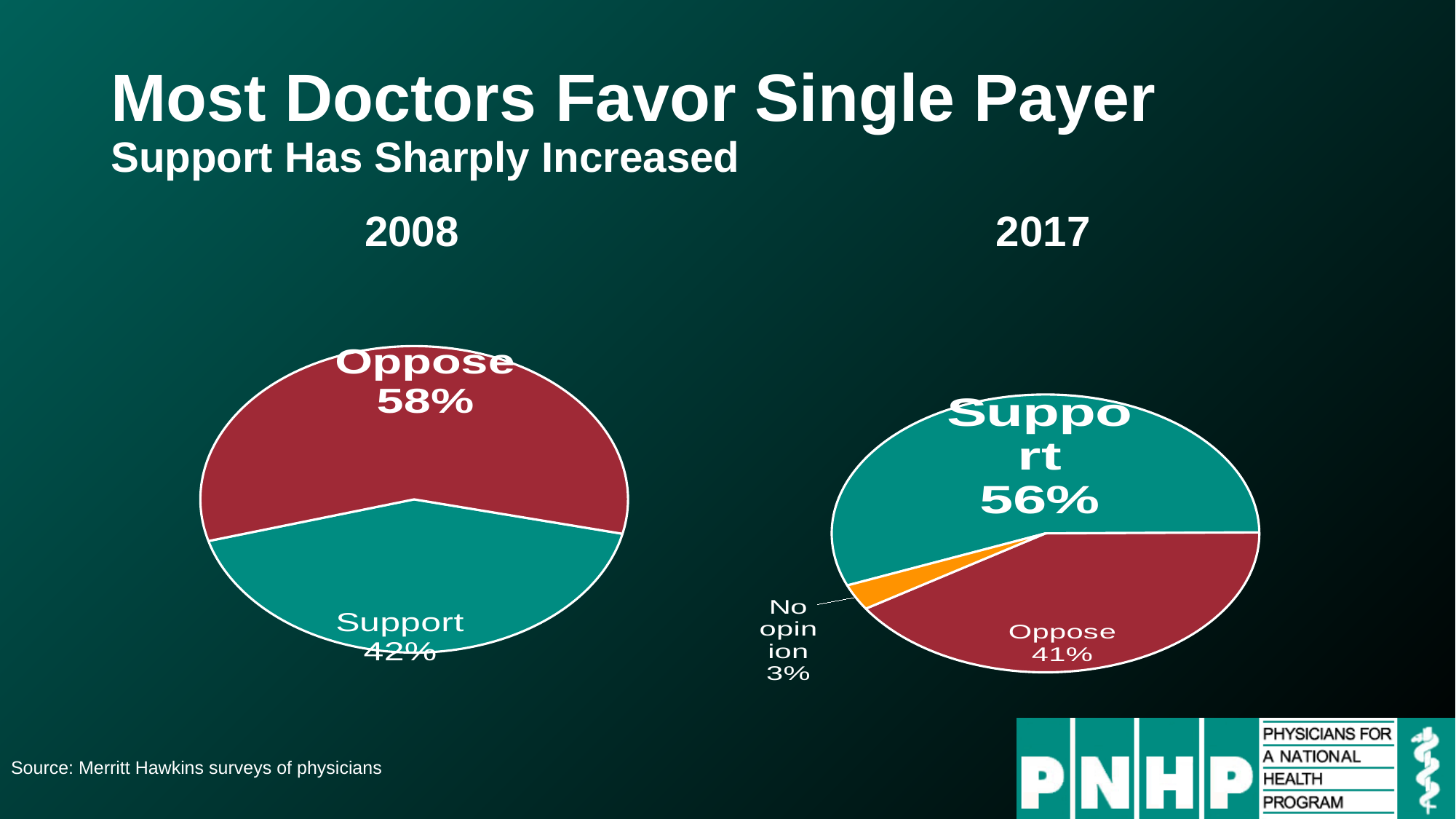
How many slices does the 2017 pie chart have? 3 In the 2008 pie chart, what is the difference in percentage points between Oppose and Support? 16 What kind of chart is used for the 2008 data? Pie chart In the 2008 pie chart, what share of doctors opposed single payer? 58% In the 2017 pie chart, which slice is the smallest? No opinion In the 2017 pie chart, what share of doctors opposed single payer? 41% In the 2017 pie chart, what share of doctors had no opinion? 3% In the 2017 pie chart, which slice is the largest? Support In the 2017 pie chart, what share of doctors supported single payer? 56% In the 2008 pie chart, which is larger, Oppose or Support? Oppose By how many percentage points did Support increase from the 2008 chart to the 2017 chart? 14 In the 2008 pie chart, what share of doctors supported single payer? 42%